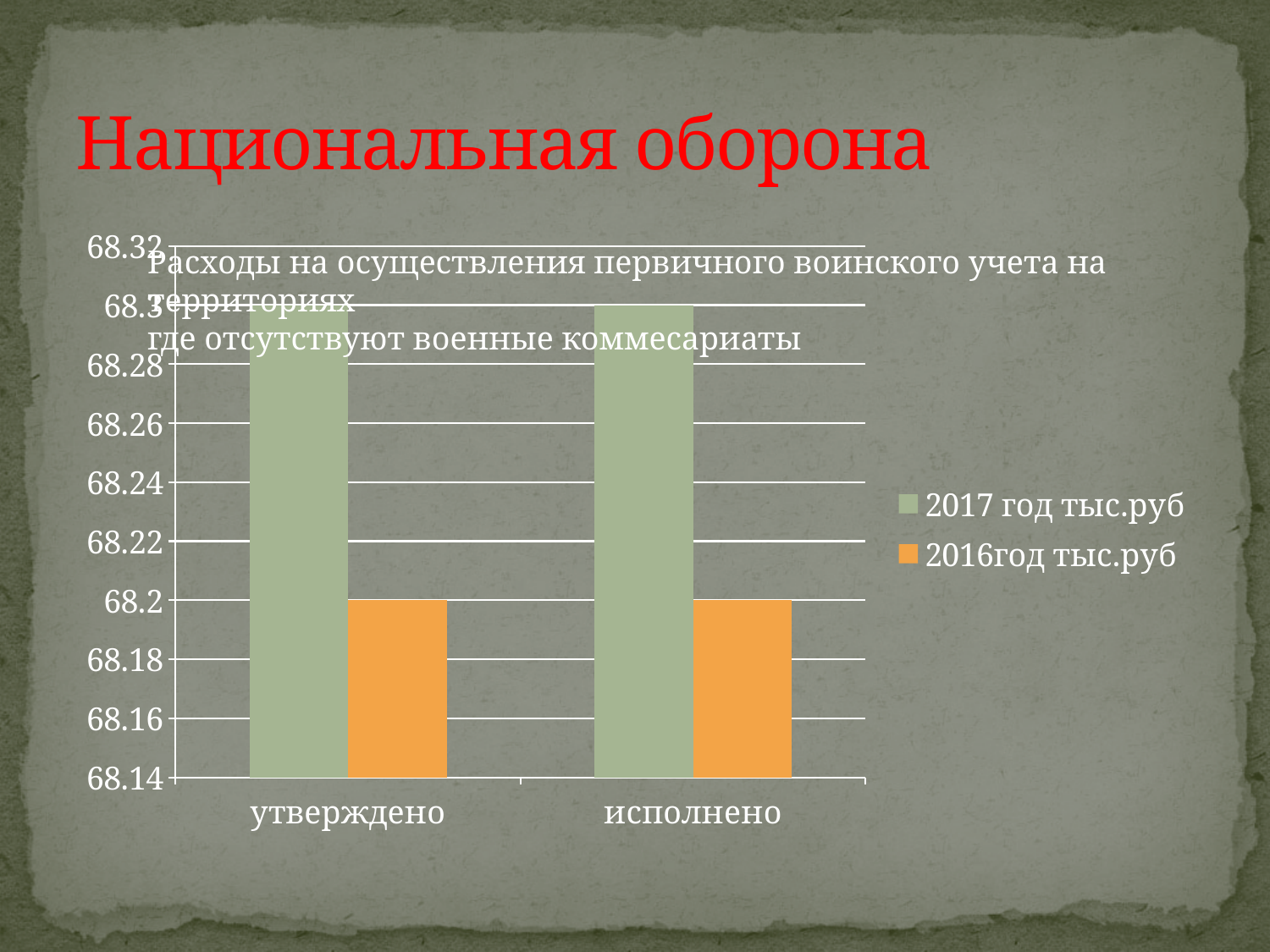
What is the value for 'исполнено' in the series '2017 год тыс.руб'? 68.3 How many categories are shown on the x axis? 2 What is the value for 'утверждено' in the series '2016год тыс.руб'? 68.2 What is the difference between the 2017 and 2016 values for 'утверждено'? 0.1 What are the two category labels on the x axis? утверждено, исполнено Which colour represents the series '2016год тыс.руб' in the legend? orange How many series does the legend list? 2 Is the value for 'утверждено' in the series '2016год тыс.руб' greater or less than 68.26? less What is the value for 'исполнено' in the series '2016год тыс.руб'? 68.2 What is the value for 'утверждено' in the series '2017 год тыс.руб'? 68.3 Which series has the larger value for 'исполнено', '2017 год тыс.руб' or '2016год тыс.руб'? 2017 год тыс.руб What type of chart is shown on the slide? bar chart